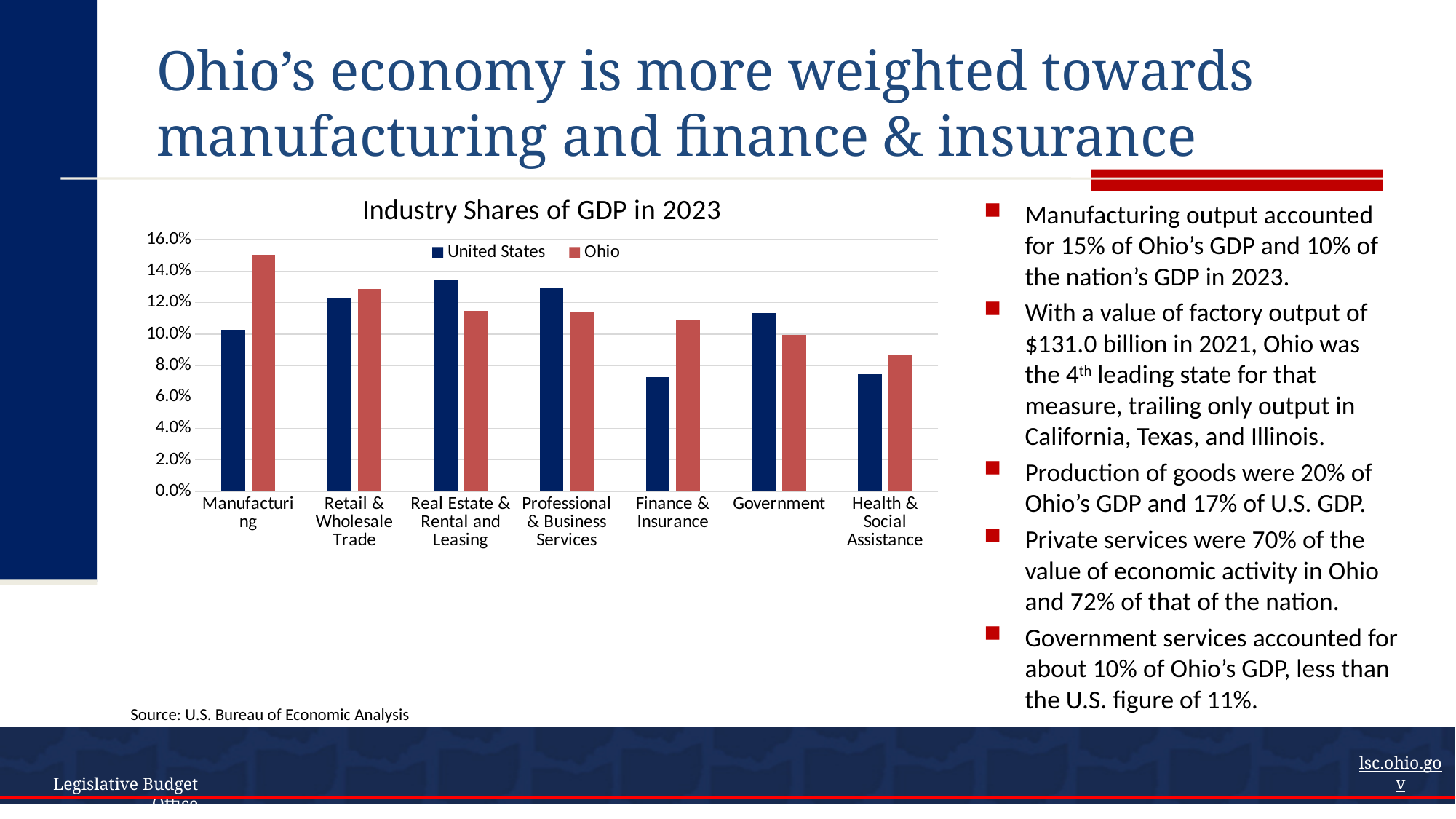
What is the title of the chart? Industry Shares of GDP in 2023 Is the Ohio value for Manufacturing greater or less than 14.0%? greater How many industry categories are shown on the x axis of the chart? 7 What type of chart is shown on the slide? Bar chart Is the Ohio value for Finance & Insurance greater or less than 10.0%? greater For Real Estate & Rental and Leasing, which is larger: the United States share or the Ohio share? United States Which industry has the highest GDP share for Ohio in the chart? Manufacturing Is the United States value for Finance & Insurance greater or less than 8.0%? less For Government, which is larger: the United States share or the Ohio share? United States How many series does the chart's legend list? 2 Which industry has the lowest GDP share for Ohio in the chart? Health & Social Assistance What source is cited for the chart's data? U.S. Bureau of Economic Analysis